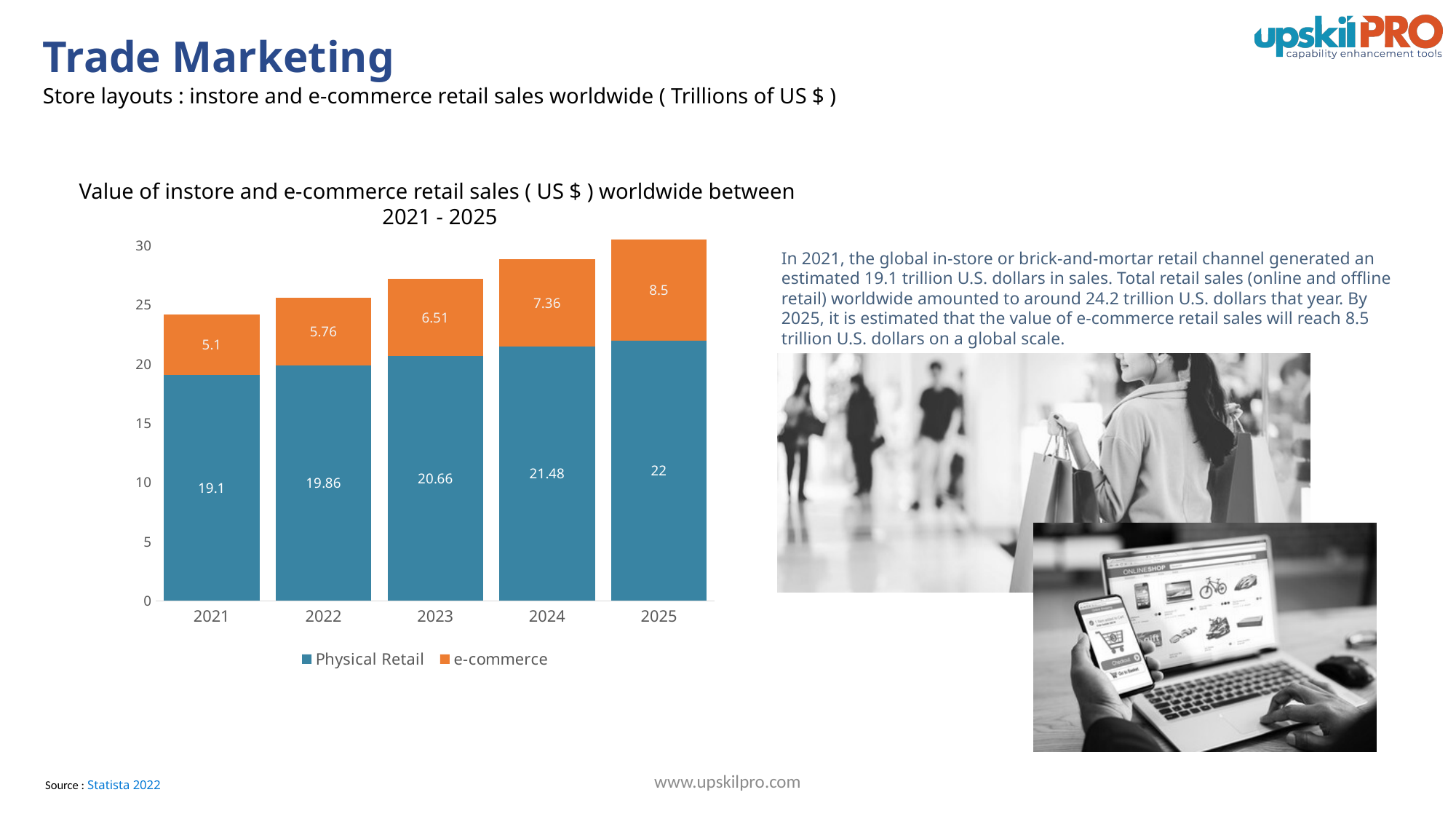
What is the total of the stacked bar for 2021? 24.2 Which year has the lowest e-commerce value? 2021 What is the total of the stacked bar for 2025? 30.5 How many years are shown on the x axis? 5 What is the e-commerce value for 2024? 7.36 How many series does the legend list? 2 What is the difference between the Physical Retail values for 2025 and 2021? 2.9 Which year has the highest Physical Retail value? 2025 Which is larger, the e-commerce value for 2023 or for 2022? 2023 What kind of chart is shown? Stacked bar chart What is the Physical Retail value for 2021? 19.1 What is the e-commerce value for 2025? 8.5